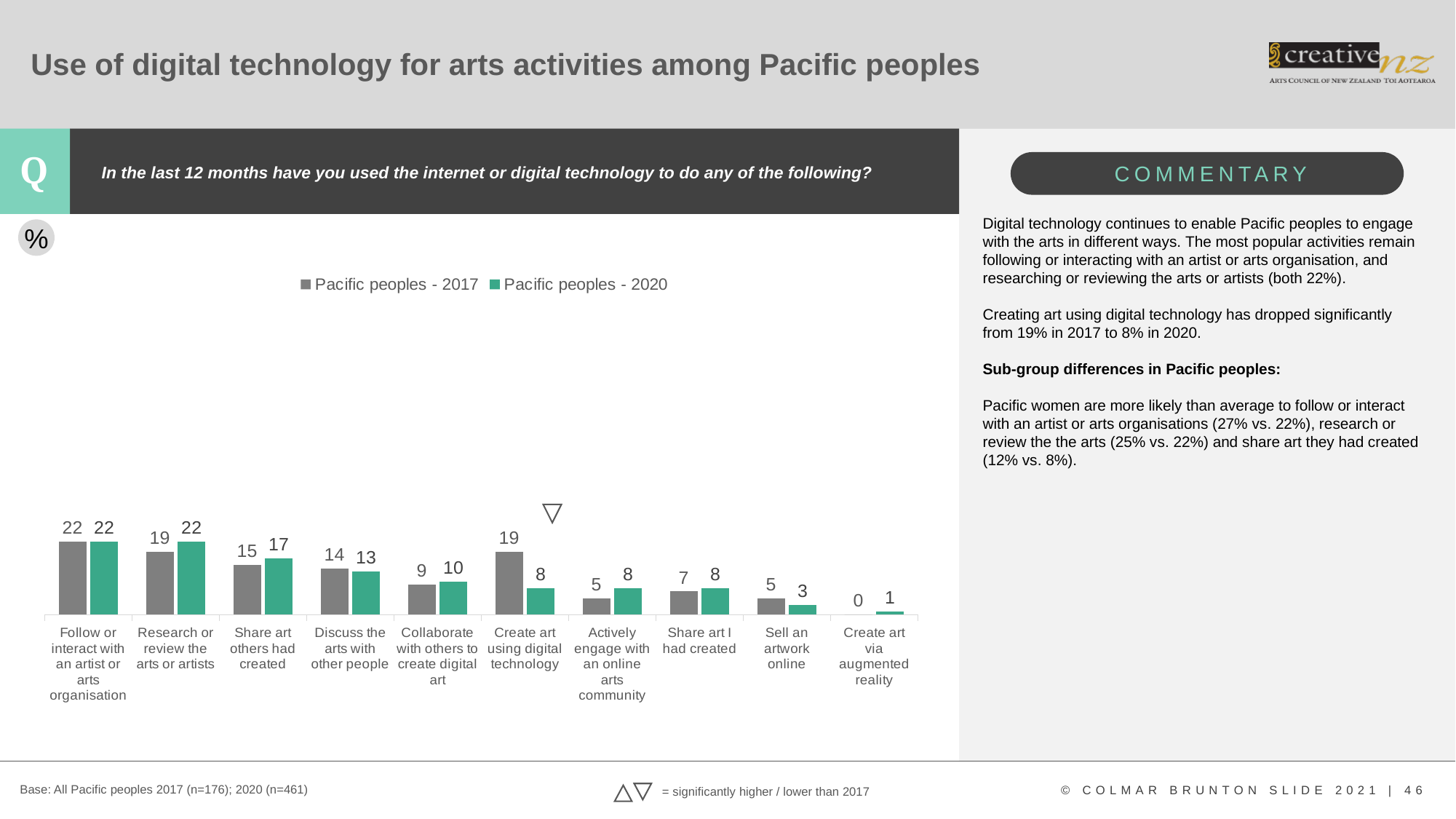
What is the difference between the 2017 and 2020 values for 'Create art using digital technology'? 11 How many categories are shown on the x axis of the chart? 10 Which category has the lowest value in the Pacific peoples - 2017 series? Create art via augmented reality What is the value for 'Share art others had created' in the Pacific peoples - 2020 series? 17 Which is larger for 'Actively engage with an online arts community': the 2017 value or the 2020 value? 2020 What is the value for 'Create art using digital technology' in the Pacific peoples - 2017 series? 19 How many series does the legend list? 2 Which is larger for 'Discuss the arts with other people': the 2017 value or the 2020 value? 2017 What is the value for 'Sell an artwork online' in the Pacific peoples - 2020 series? 3 Which category has the highest value in the Pacific peoples - 2020 series? Follow or interact with an artist or arts organisation and Research or review the arts or artists (both 22) What are the two series names listed in the legend? Pacific peoples - 2017 and Pacific peoples - 2020 What kind of chart is shown on the slide? Bar chart